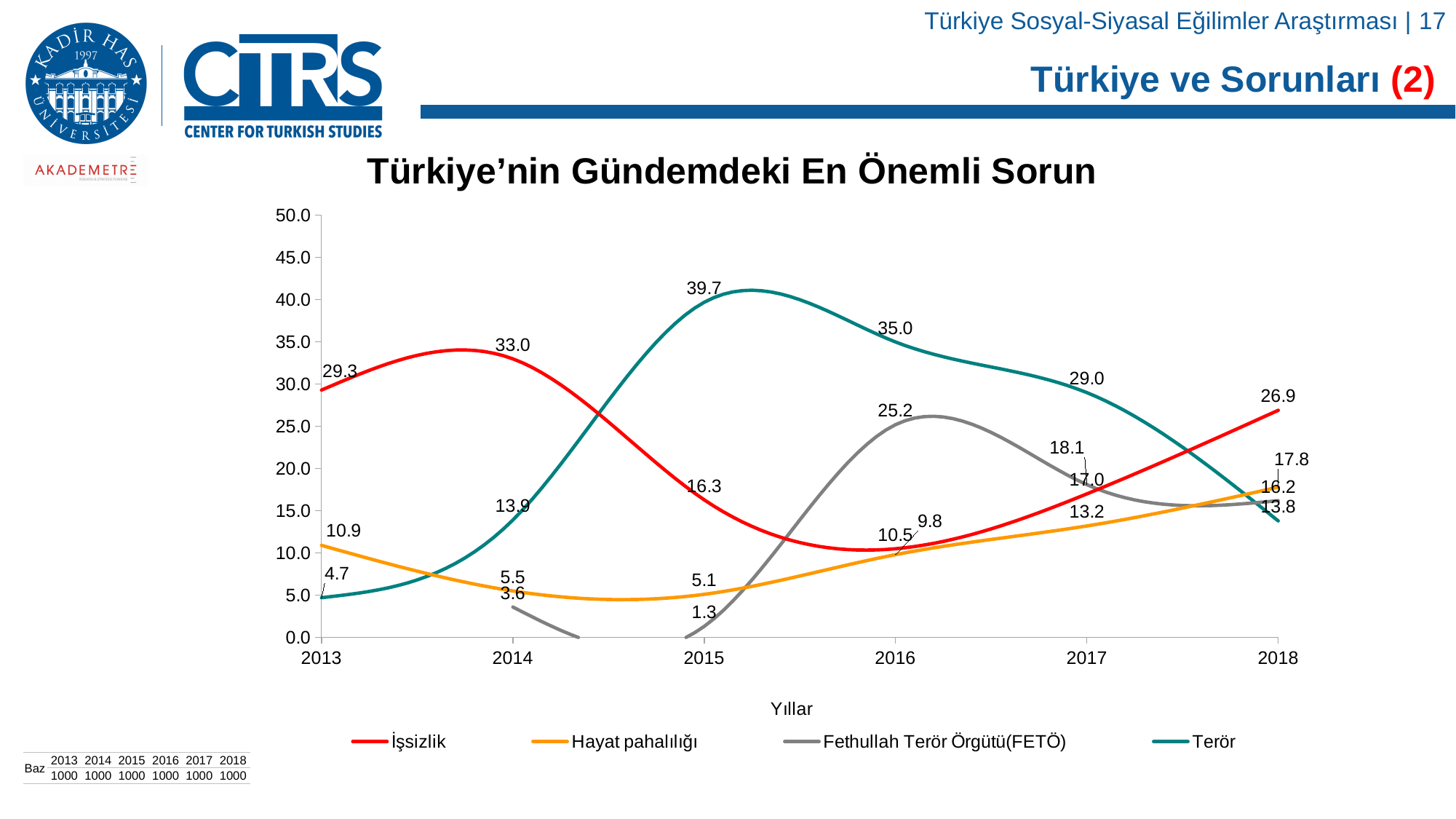
In which year does the İşsizlik series reach its lowest value? 2016 What kind of chart is shown on the slide? line chart Does the Hayat pahalılığı series rise or fall from 2015 to 2018? rise What is the value for Terör in 2015? 39.7 What is the difference between the İşsizlik values in 2014 and 2013? 3.7 What is the value for İşsizlik in 2014? 33.0 How many series does the legend list? 4 How many years are shown on the x axis? 6 In 2016, which is larger: Terör or Fethullah Terör Örgütü(FETÖ)? Terör What is the difference between the Terör values in 2015 and 2016? 4.7 What is the value for Hayat pahalılığı in 2013? 10.9 In which year does the Terör series reach its highest value? 2015